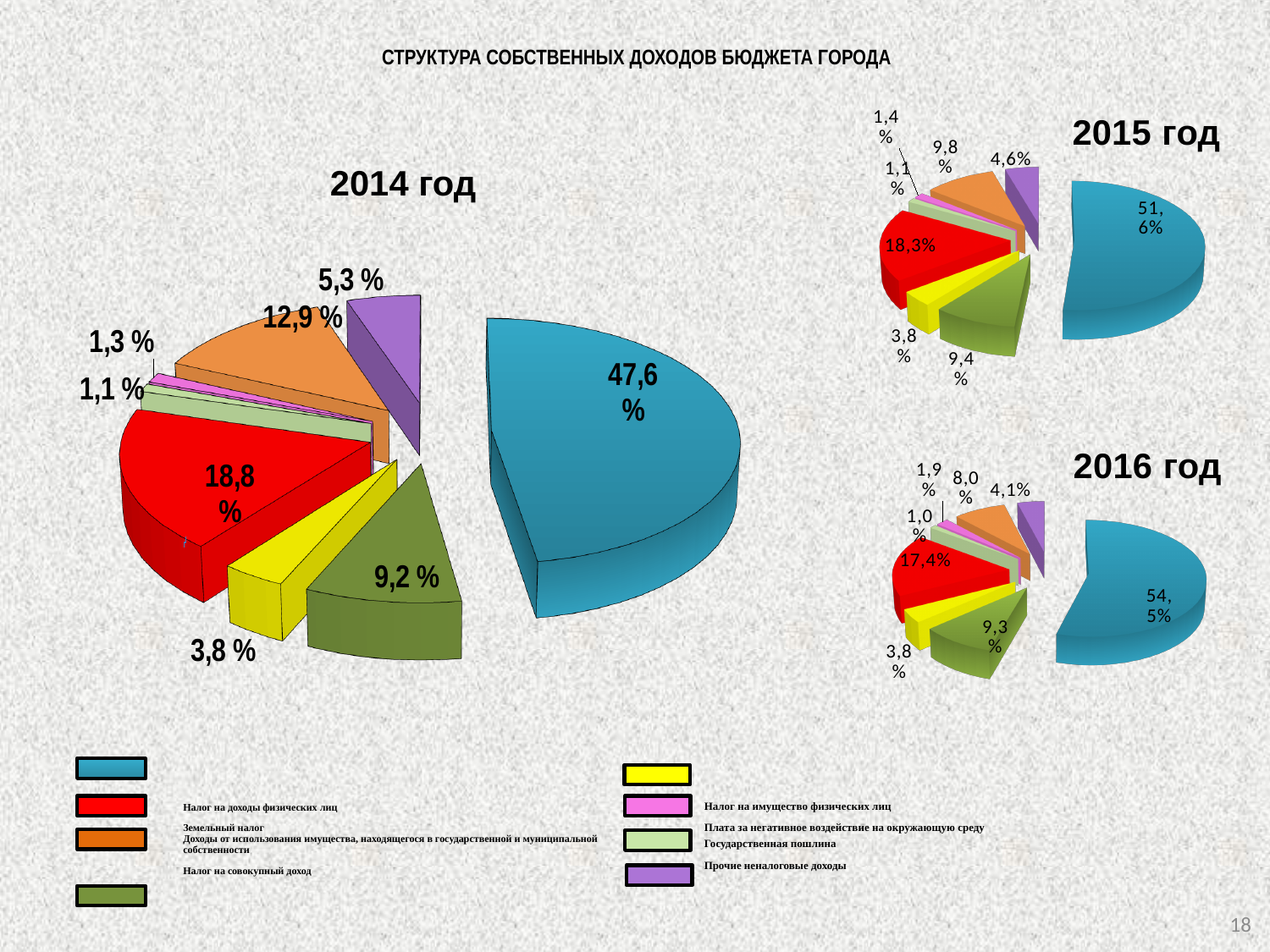
In the 2014 год pie chart, what share does the red slice have? 18,8 % Which is larger in the 2016 год pie chart: the green slice (9,3%) or the orange slice (8,0%)? the green slice (9,3%) How many slices does the 2014 год pie chart have? 8 What is the title of the slide containing the three pie charts? СТРУКТУРА СОБСТВЕННЫХ ДОХОДОВ БЮДЖЕТА ГОРОДА In the 2015 год pie chart, what share does the blue slice have? 51,6% In the 2016 год pie chart, what share does the orange slice have? 8,0% In the 2014 год pie chart, which slice has the smallest share? 1,1 % In the 2014 год pie chart, what is the difference between the blue slice (47,6 %) and the red slice (18,8 %)? 28,8 % What type of chart is used for each year on this slide? pie chart In the 2014 год pie chart, what share does the largest (blue) slice have? 47,6 % In the 2016 год pie chart, what share does the red slice have? 17,4% In the 2015 год pie chart, what is the largest share shown? 51,6%